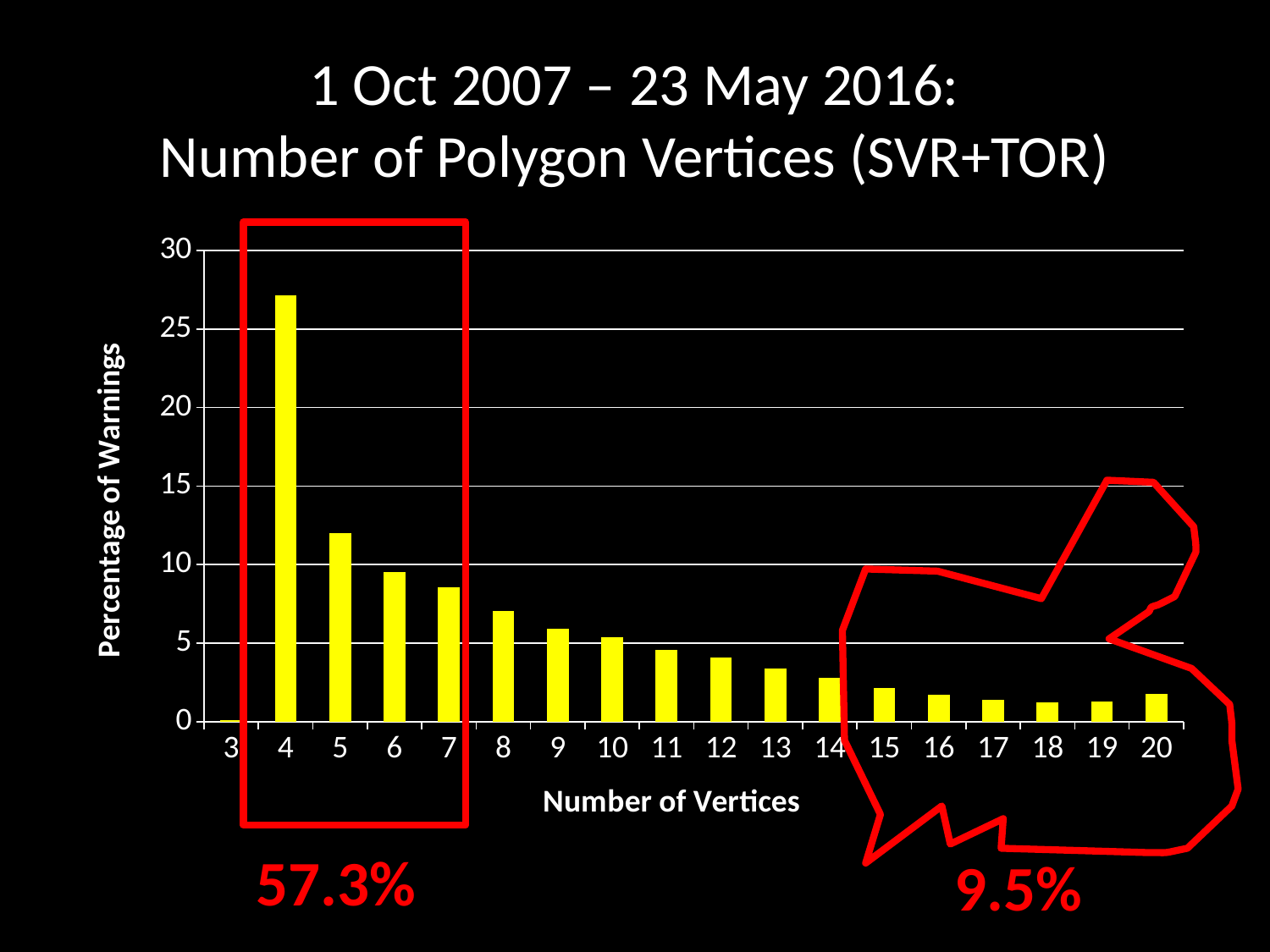
Which has a higher percentage of warnings, 5 vertices or 6 vertices? 5 vertices Is the percentage of warnings for 13 vertices greater or less than 5? less What percentage is written below the red box around 4 to 7 vertices? 57.3% Which number of vertices has the lowest percentage of warnings? 3 Is the percentage of warnings for 4 vertices greater or less than 25? greater What kind of chart is shown on the slide? bar chart Which number of vertices has the highest percentage of warnings? 4 What percentage is written below the red outline around 15 to 20 vertices? 9.5% Do the percentages generally rise or fall as the number of vertices increases from 4 to 20? fall How many vertex categories are plotted along the x axis? 18 Is the percentage of warnings for 8 vertices greater or less than 5? greater